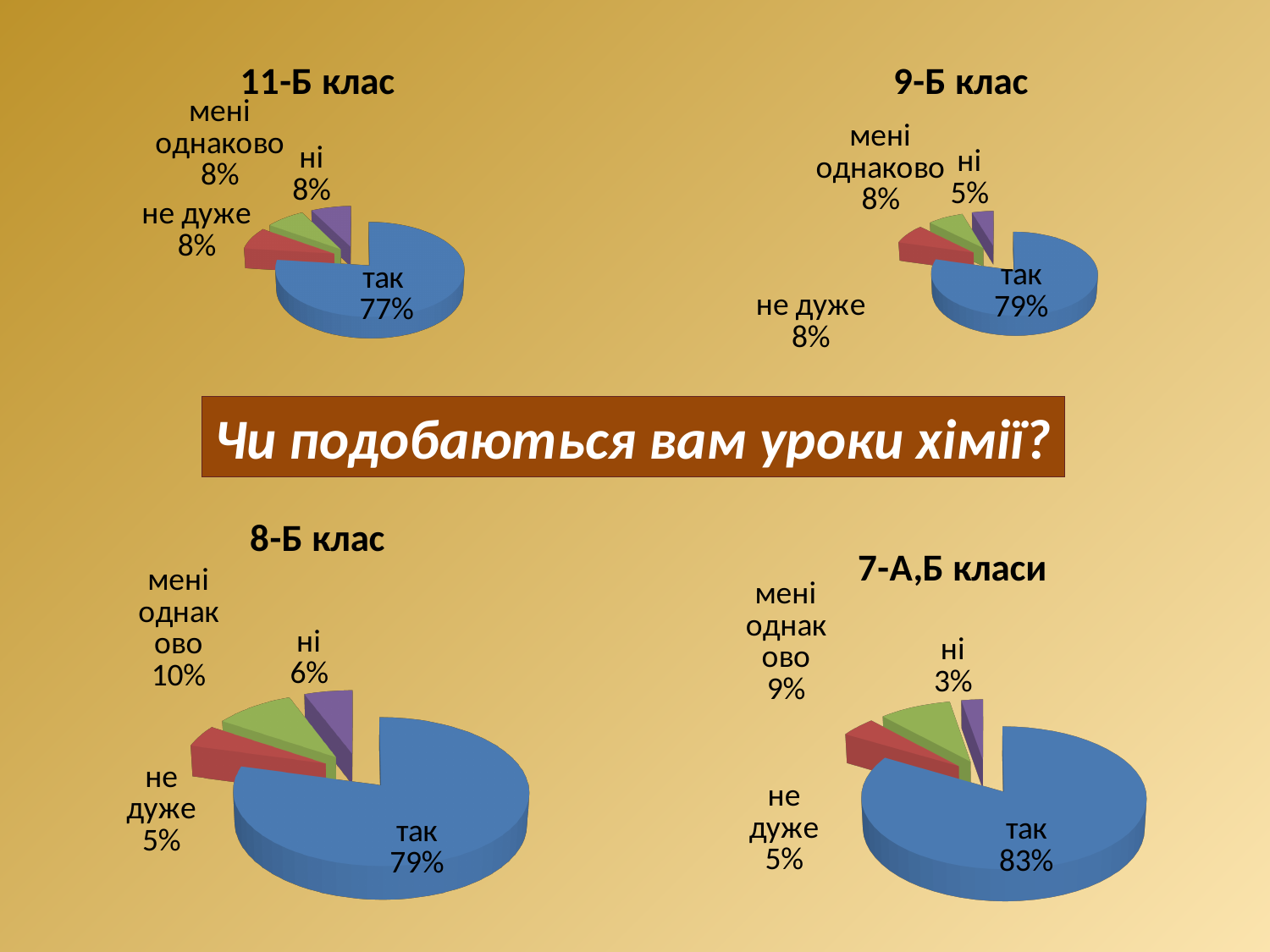
How many charts are on the slide? 4 How many slices does the "11-Б клас" chart have? 4 In the "7-А,Б класи" chart, which category has the smallest slice? ні What is the title of the chart in the bottom-right of the slide? 7-А,Б класи In the "9-Б клас" chart, what is the difference between "так" and "не дуже"? 71% In the "11-Б клас" chart, what share of the pie is "так"? 77% What kind of chart is the "9-Б клас" chart? pie chart In the "8-Б клас" chart, what is the value for "мені однаково"? 10% In the "8-Б клас" chart, which is larger, "мені однаково" or "ні"? мені однаково In the "7-А,Б класи" chart, what is the value for "так"? 83% In the "8-Б клас" chart, which category has the largest slice? так In the "9-Б клас" chart, what is the value for "ні"? 5%